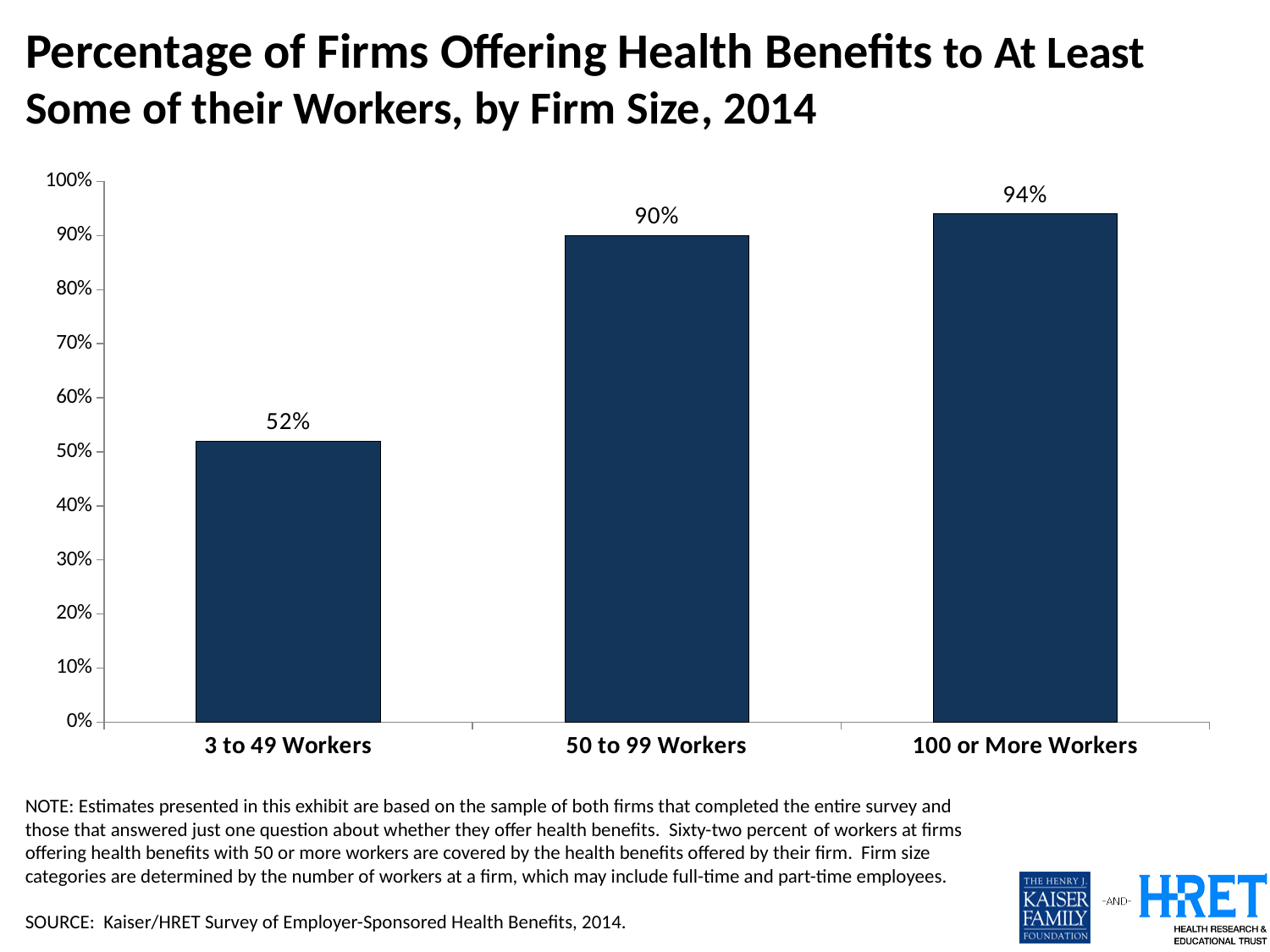
Which is larger: the value for 3 to 49 Workers or the value for 50 to 99 Workers? 50 to 99 Workers What percentage of firms with 100 or more workers offer health benefits? 94% What kind of chart is shown on the slide? Bar chart Do the values rise or fall as firm size increases along the x axis? Rise What percentage of firms with 3 to 49 workers offer health benefits? 52% What is the difference in percentage points between firms with 100 or more workers and firms with 3 to 49 workers? 42 Is the value for 3 to 49 Workers greater or less than 60%? less How many firm size categories are shown in the chart? 3 What percentage of firms with 50 to 99 workers offer health benefits? 90% Which firm size category has the highest percentage of firms offering health benefits? 100 or More Workers What is the difference in percentage points between firms with 100 or more workers and firms with 50 to 99 workers? 4 Which firm size category has the lowest percentage of firms offering health benefits? 3 to 49 Workers